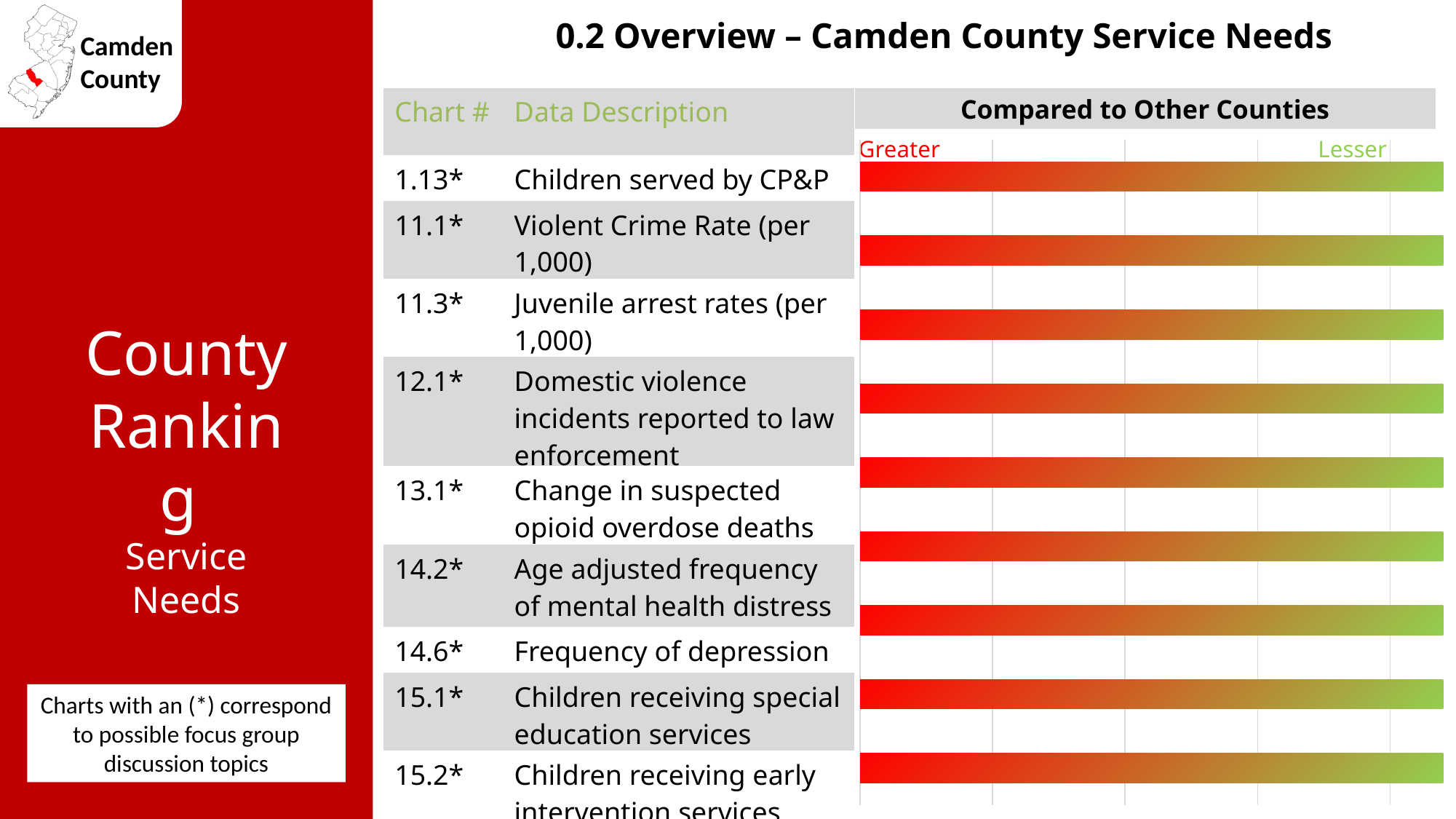
Which data description is listed for chart 13.1*? Change in suspected opioid overdose deaths How many bars are plotted in the "Compared to Other Counties" chart? 9 What label appears at the right end of the chart's axis? Lesser What kind of chart is shown under "Compared to Other Counties"? bar chart Which chart number corresponds to "Frequency of depression"? 14.6* What is the title of the chart on the right side of the slide? Compared to Other Counties Which data description is listed for chart 11.1*? Violent Crime Rate (per 1,000) What label appears at the left end of the chart's axis? Greater Which chart number corresponds to "Children served by CP&P"? 1.13*